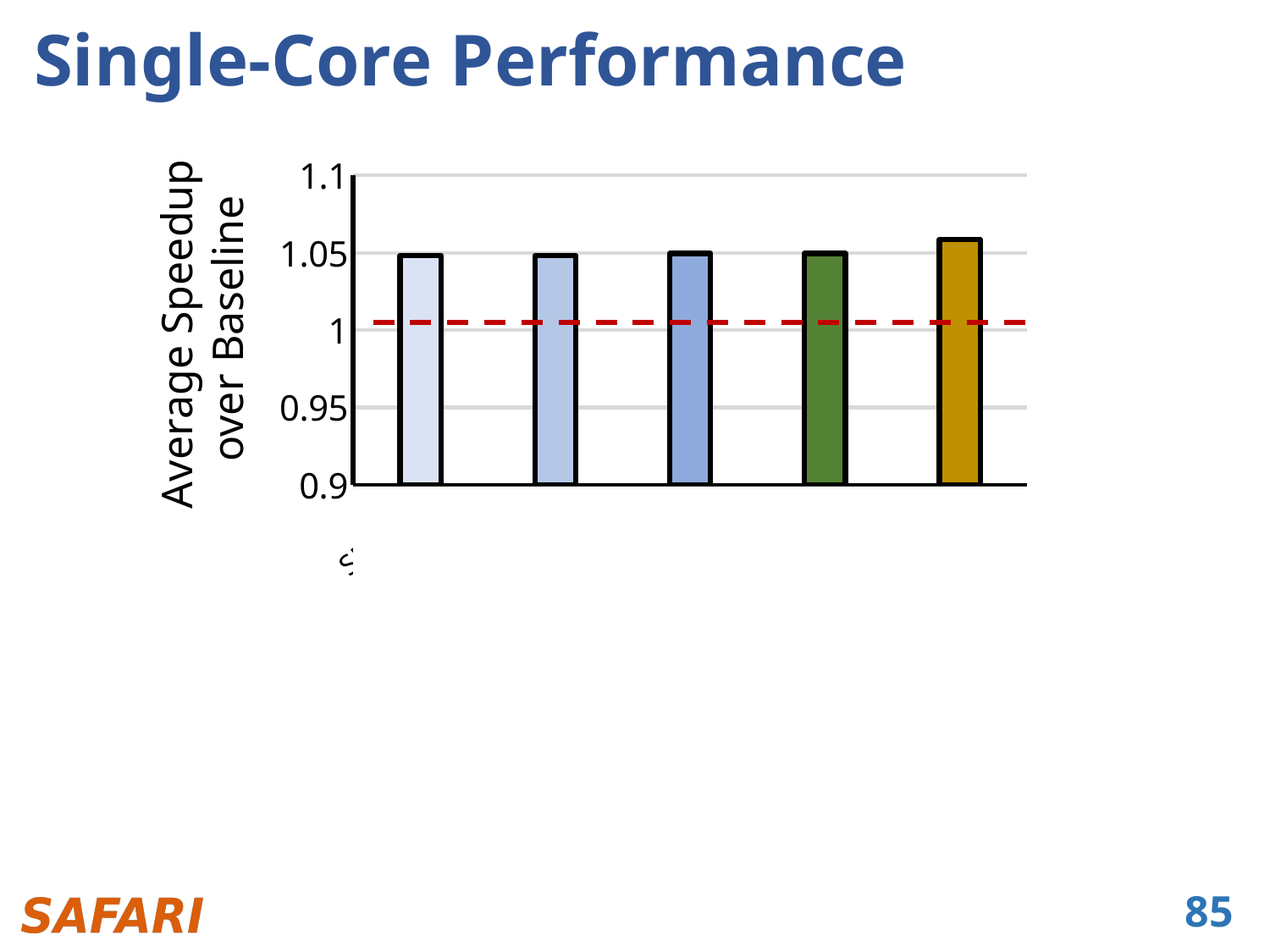
Which bar is the highest in the chart? the rightmost (gold) bar Is the value for the rightmost (gold) bar greater or less than 1.1? less Is the rightmost (gold) bar higher or lower than the leftmost bar? higher What is the label of the vertical axis? Average Speedup over Baseline What value does the dashed red horizontal line mark on the vertical axis? 1 Is the value for the green bar greater or less than 0.95? greater How many bars are plotted in the chart? 5 What kind of chart is shown on the slide? bar chart What is the lowest value shown on the vertical axis? 0.9 Is the value for the leftmost bar greater or less than 1? greater